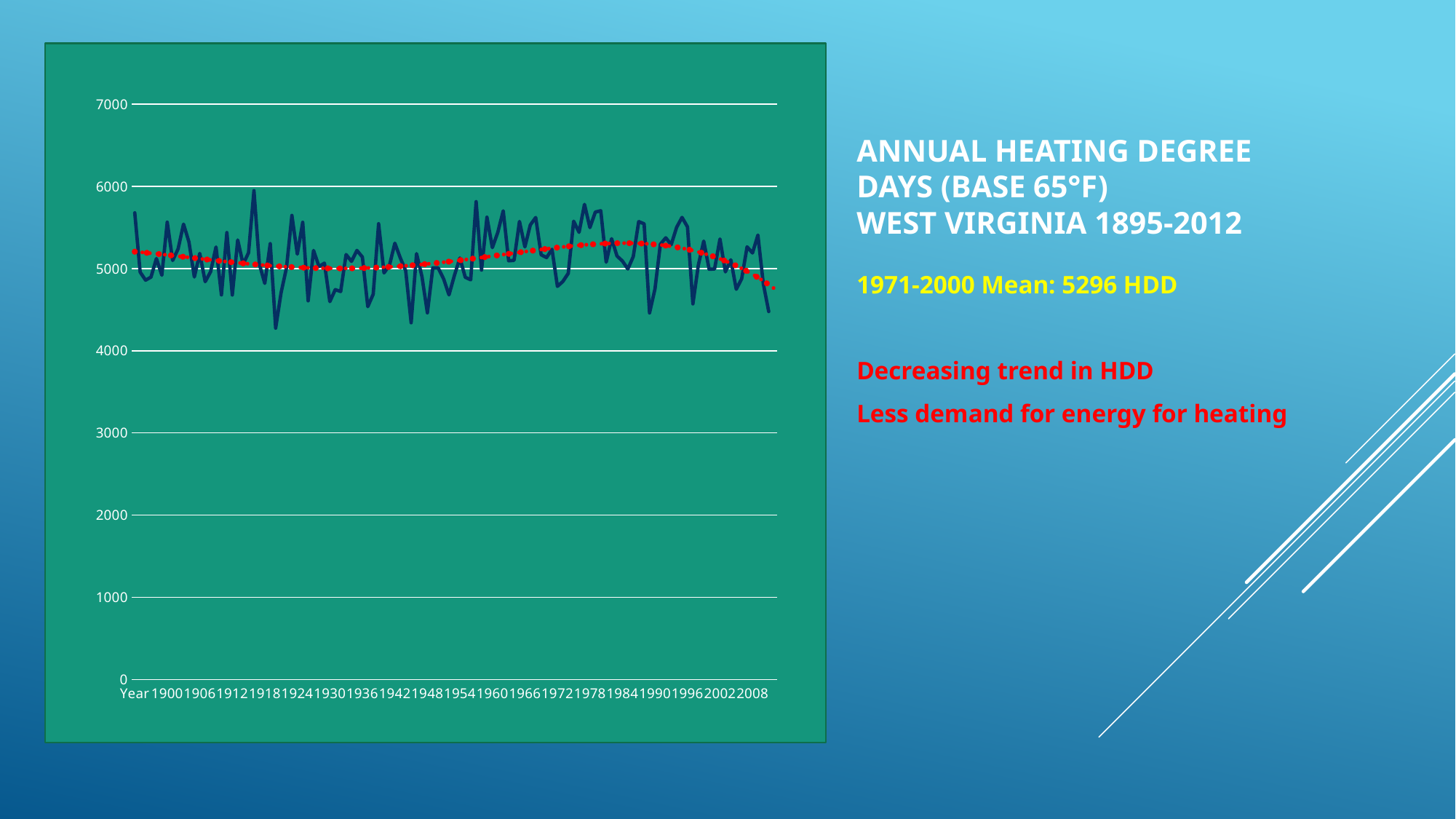
Do any of the plotted annual values rise above 6000 on the chart? No What is the interval between consecutive tick labels on the chart's vertical axis? 1000 What kind of chart is shown on the slide? Line chart Is the last plotted value on the chart (around 2012) greater or less than 5000? less What is the highest value shown on the chart's vertical axis? 7000 Is the red dotted trend line at the right end of the chart greater or less than 5000? less According to the slide, what is the overall trend in heating degree days? Decreasing What is the title of the chart on the slide? Annual Heating Degree Days (Base 65°F) West Virginia 1895-2012 What is the 1971-2000 mean HDD value stated on the slide? 5296 HDD